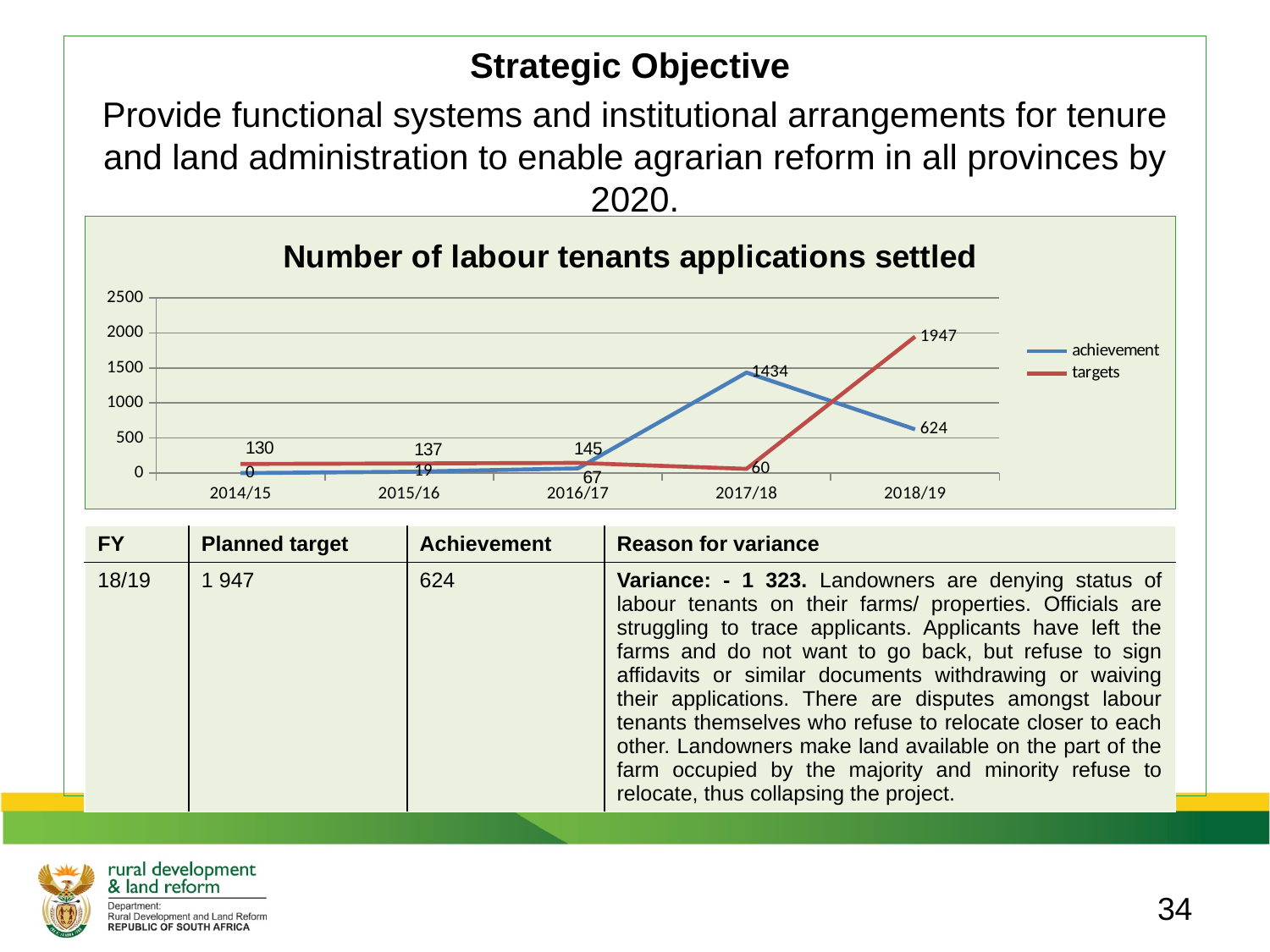
What is the achievement value for 2016/17? 67 What is the difference between the targets value and the achievement value for 2018/19? 1323 What is the achievement value for 2017/18? 1434 What is the title of the chart? Number of labour tenants applications settled Which is larger in 2017/18, the achievement value or the targets value? achievement How many financial years are plotted on the x axis of the chart? 5 In which financial year is the targets value lowest? 2017/18 What is the targets value for 2014/15? 130 What kind of chart is shown on the slide? line chart How many series does the chart legend list? 2 In which financial year is the achievement value highest? 2017/18 What is the targets value for 2018/19? 1947